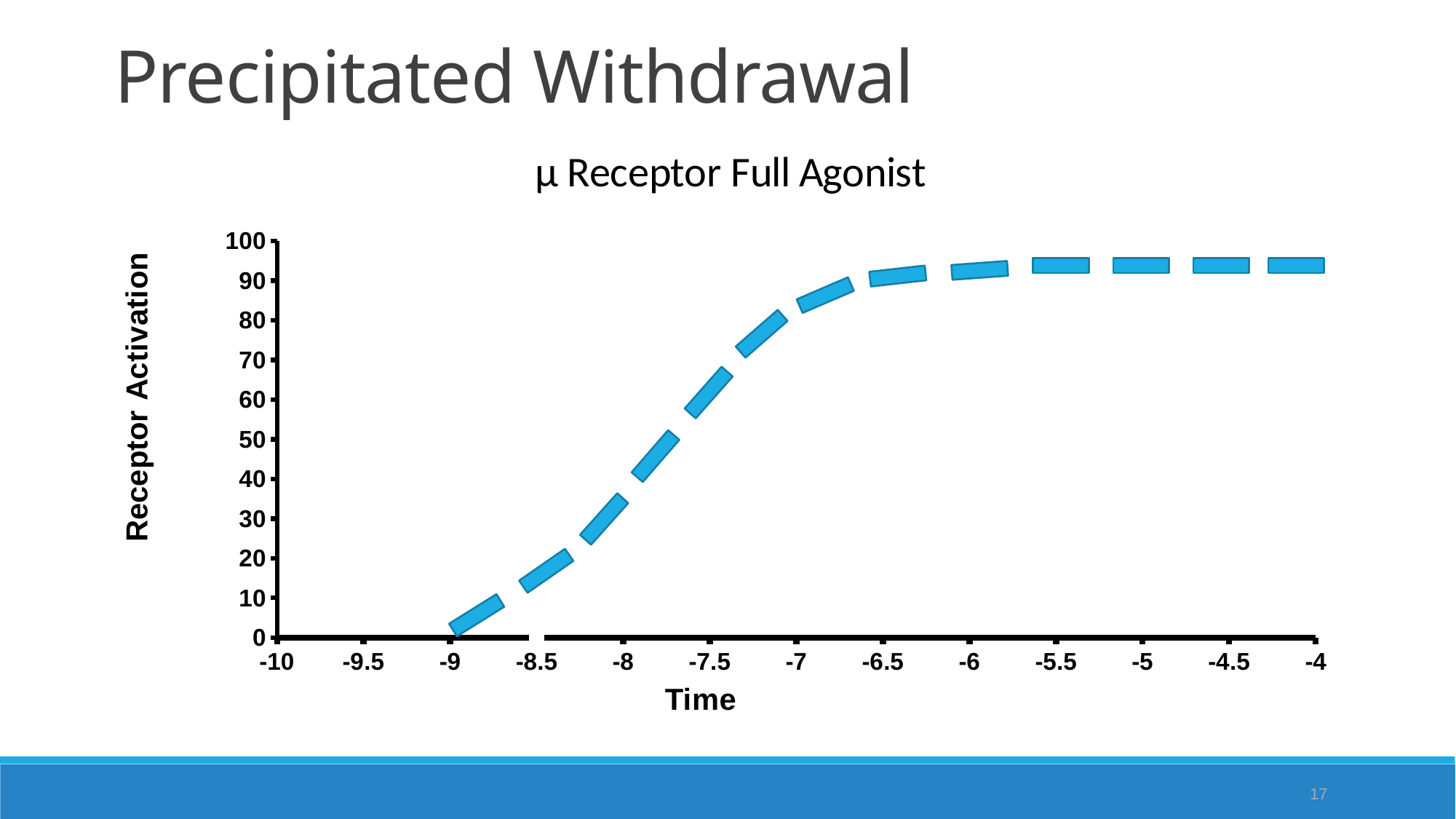
What kind of chart is shown on the slide? line chart Does Receptor Activation rise or fall as Time goes from -9 to -7? rise Is the value for Receptor Activation at Time -8.5 greater or less than 20? less Is the value for Receptor Activation at Time -8 greater or less than 50? less Is the value for Receptor Activation at Time -7.5 greater or less than 50? greater How many tick labels are shown on the Time axis? 13 What is the label of the y axis? Receptor Activation Which Time has the lower Receptor Activation, -9 or -6? -9 What is the title of the chart? μ Receptor Full Agonist